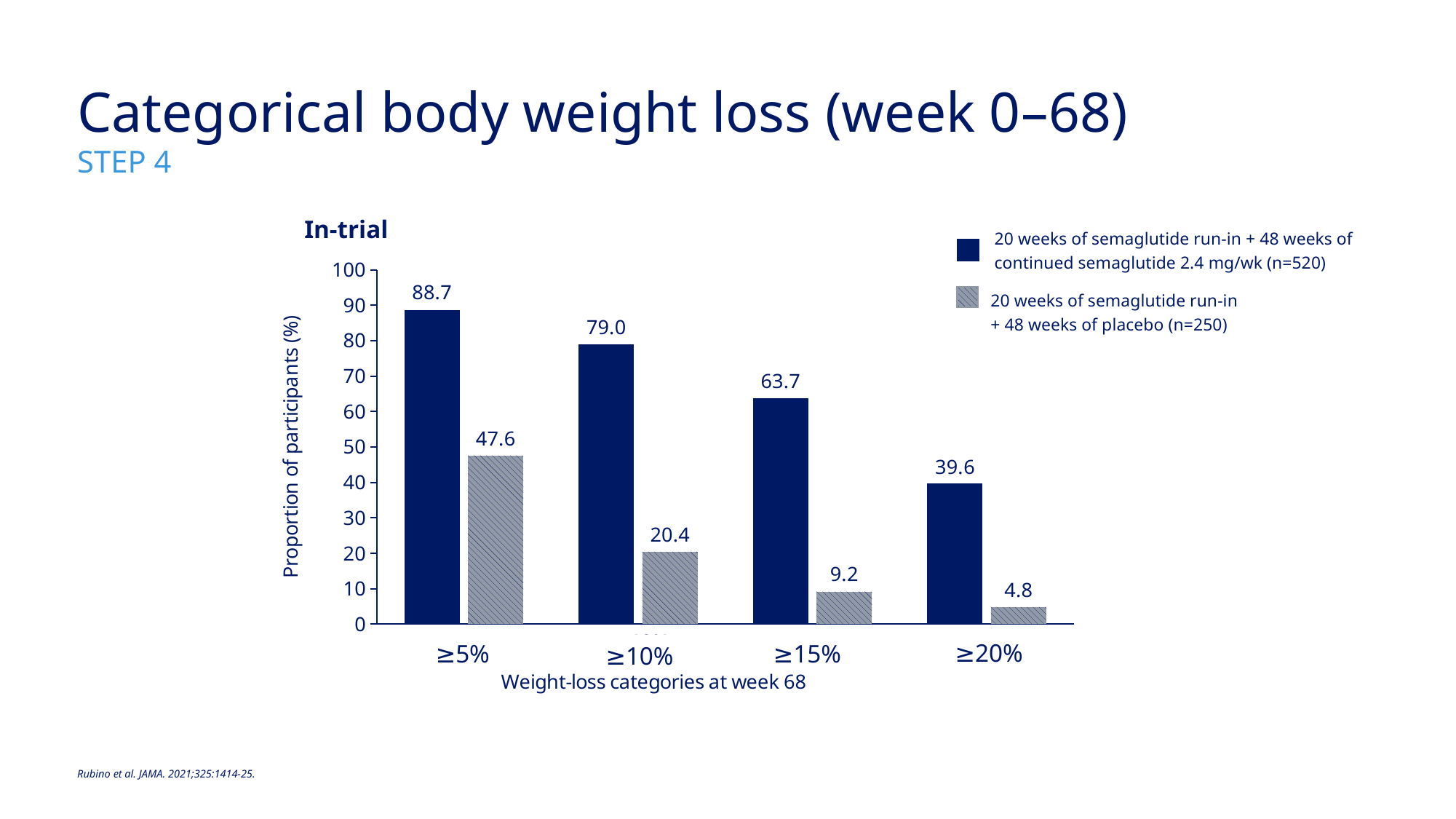
Which weight-loss category has the highest value for the continued semaglutide group? ≥5% Do the values for the continued semaglutide group rise or fall from ≥5% to ≥20%? Fall What kind of chart is shown on the slide? Bar chart How many weight-loss categories are shown on the x axis? 4 Which weight-loss category has the lowest value for the placebo group? ≥20% Which is larger: the placebo value for ≥5% or the continued semaglutide value for ≥20%? Placebo value for ≥5% What proportion of participants in the placebo group achieved ≥10% weight loss? 20.4 How many series does the legend list? 2 What is the difference between the continued semaglutide and placebo values in the ≥15% weight-loss category? 54.5 What proportion of participants in the continued semaglutide group achieved ≥5% weight loss? 88.7 What is the value for the continued semaglutide group in the ≥20% weight-loss category? 39.6 What is the label on the y axis? Proportion of participants (%)